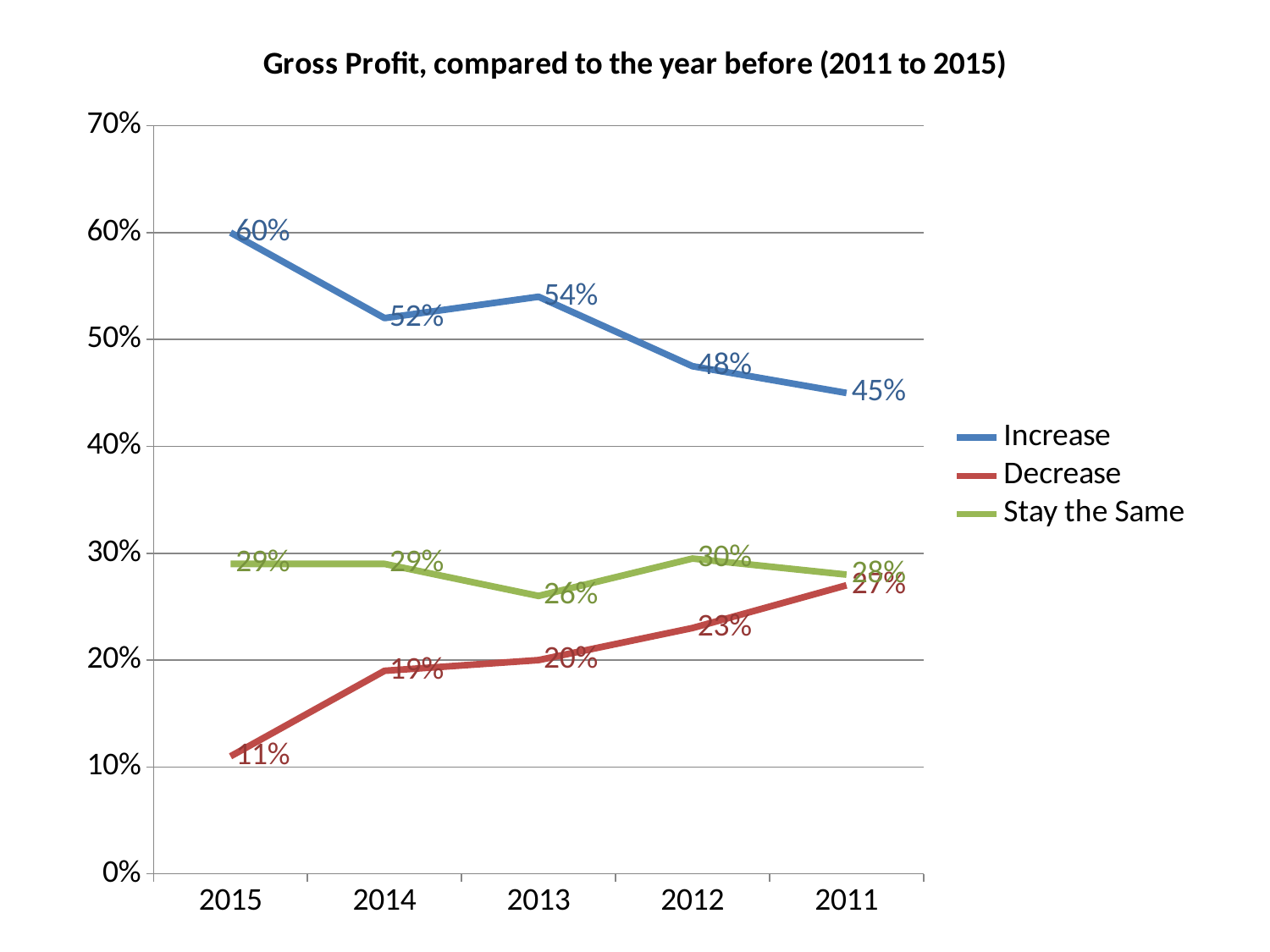
What is the difference between the Increase values for 2015 and 2011? 15% What is the value for Decrease in 2011? 27% What is the title of the chart? Gross Profit, compared to the year before (2011 to 2015) What kind of chart is this? Line chart How many series does the legend list? 3 In which year is the Increase series at its lowest? 2011 What is the value for Stay the Same in 2013? 26% In which year is the Decrease series at its highest? 2011 What is the value for Increase in 2015? 60% Which is larger in 2014: Decrease or Stay the Same? Stay the Same Is the value for Increase in 2012 greater or less than 40%? greater How many years are shown on the x axis? 5